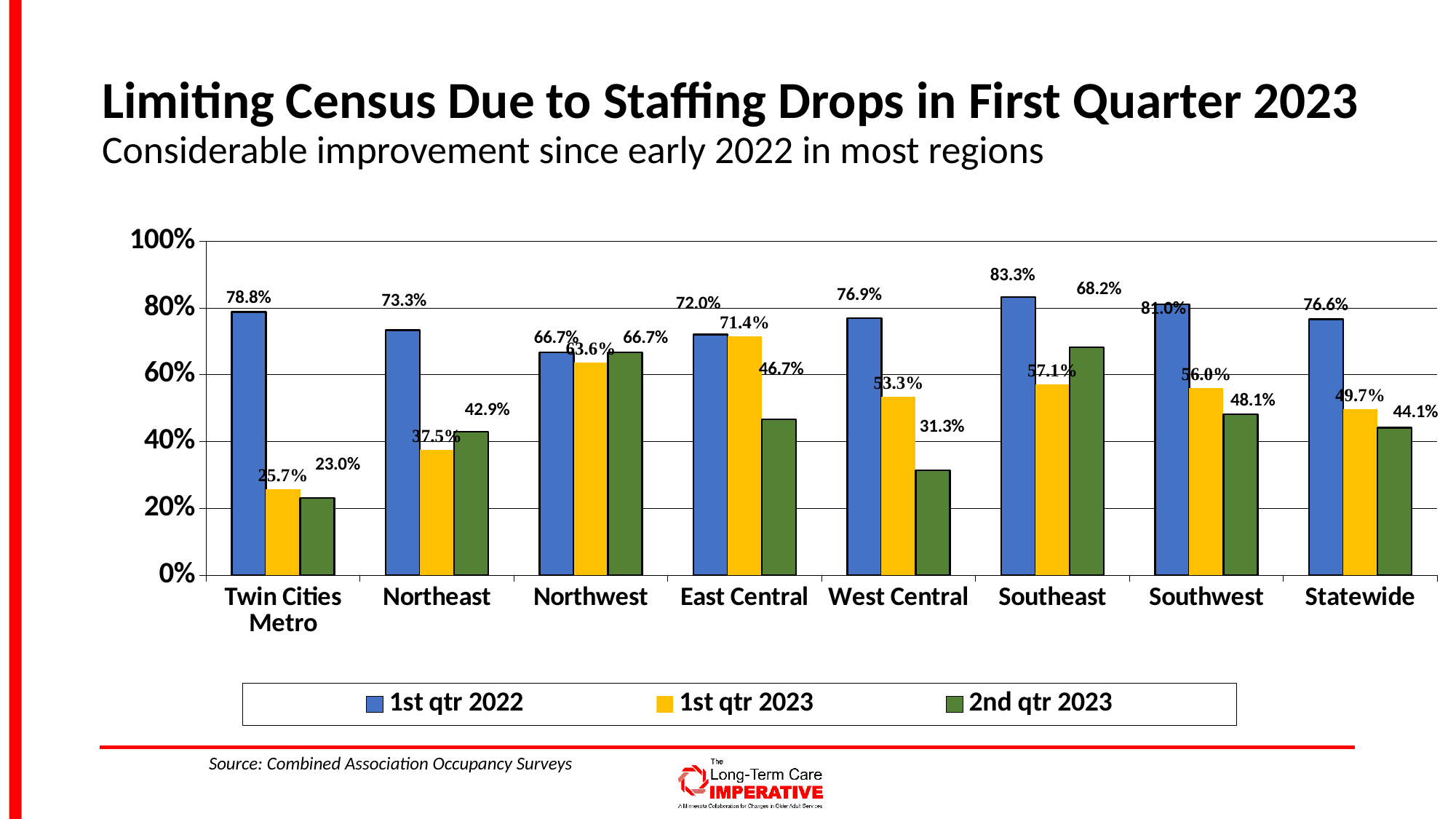
For Northeast, which is larger: the 1st qtr 2023 value or the 2nd qtr 2023 value? 2nd qtr 2023 What is the 1st qtr 2023 value for Statewide? 49.7% Which region has the highest 1st qtr 2023 value? East Central How many series does the legend list? 3 What is the difference between the 1st qtr 2022 and 2nd qtr 2023 values for Twin Cities Metro? 55.8 percentage points Is the 1st qtr 2022 value for Southeast greater or less than 80%? greater What is the 2nd qtr 2023 value for West Central? 31.3% Which region has the lowest 2nd qtr 2023 value? Twin Cities Metro What is the value for Twin Cities Metro in the 1st qtr 2022 series? 78.8% What kind of chart is shown on the slide? Bar chart How many regions are shown on the x axis? 8 Which region has the highest 1st qtr 2022 value? Southeast